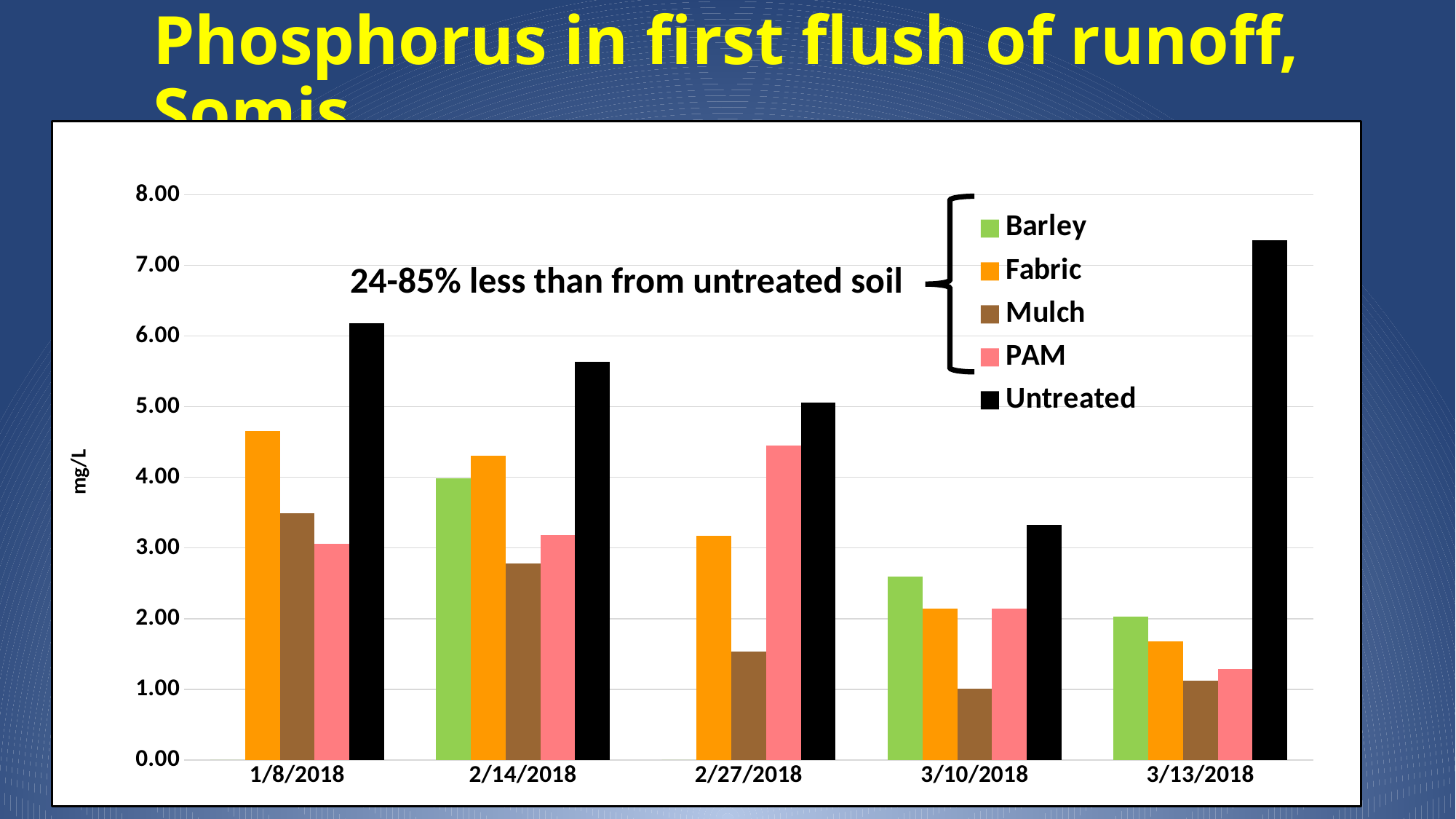
How many dates are shown along the x axis? 5 Is the Untreated value for 3/13/2018 greater or less than 7.00? greater What is the label on the y axis? mg/L Which series has the lowest value on 3/13/2018? Mulch What kind of chart is shown on the slide? bar chart Is the Mulch value for 3/10/2018 greater or less than 2.00? less Is the Fabric value for 1/8/2018 greater or less than 4.00? greater On 2/27/2018, which is larger, the PAM value or the Fabric value? PAM On which date is the Untreated value highest? 3/13/2018 On 3/10/2018, which is larger, the Barley value or the Fabric value? Barley How many series does the legend list? 5 On which date is the Untreated value lowest? 3/10/2018